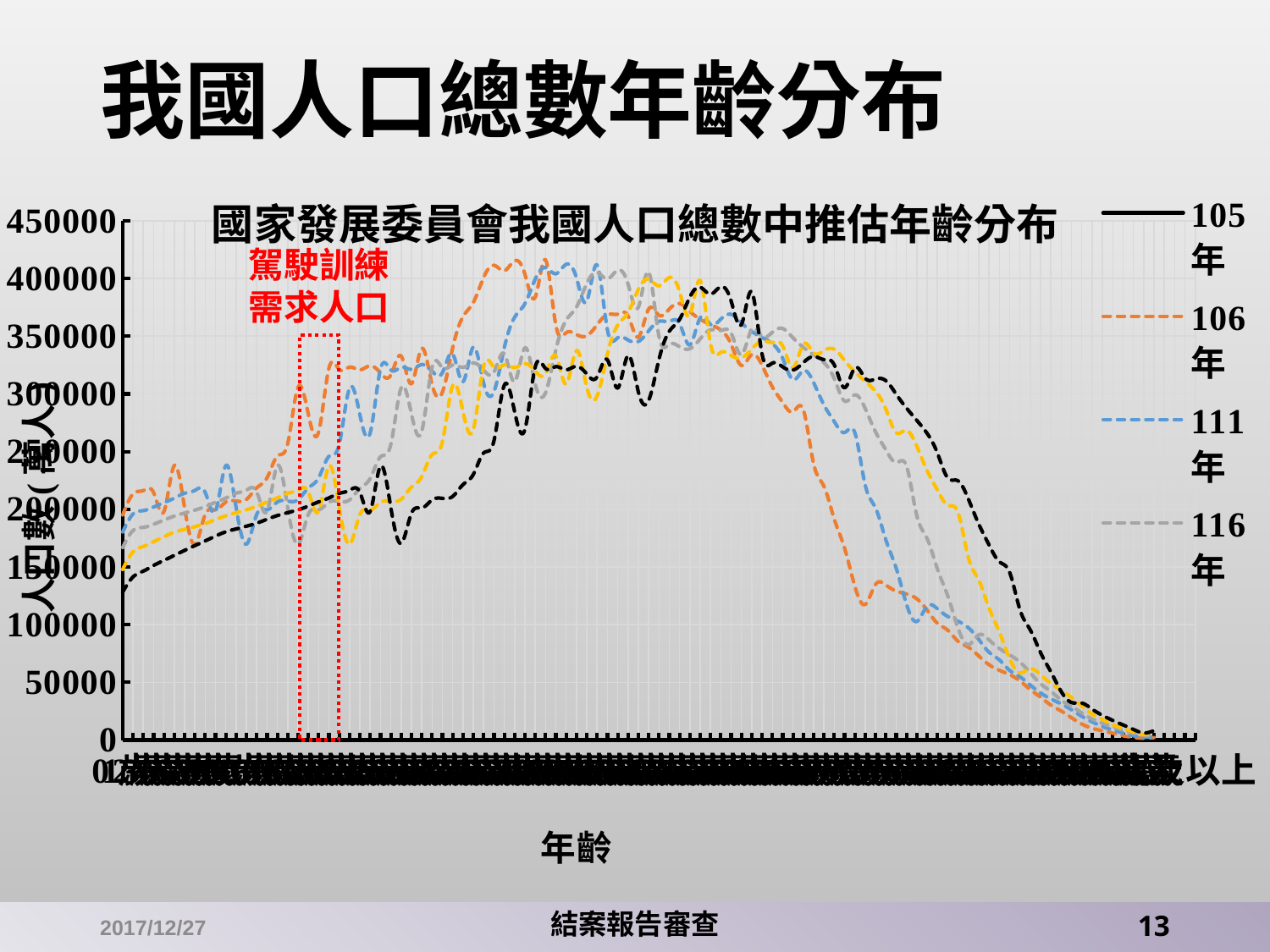
What kind of chart is shown on the slide? line chart What is the title of the chart? 國家發展委員會我國人口總數中推估年齡分布 How many series does the legend list? 4 Over the left third of the x axis, do the values of the 105年 series generally rise or fall? rise Is the highest value reached by the 111年 series greater or less than 400000? greater What does the red annotation next to the dotted red box say? 駕駛訓練需求人口 Is the value of the 105年 series at the leftmost age category greater or less than 200000? less Is the highest value reached by the 106年 series greater or less than 400000? greater Over the right half of the x axis, do the values of the 105年 series rise or fall? fall